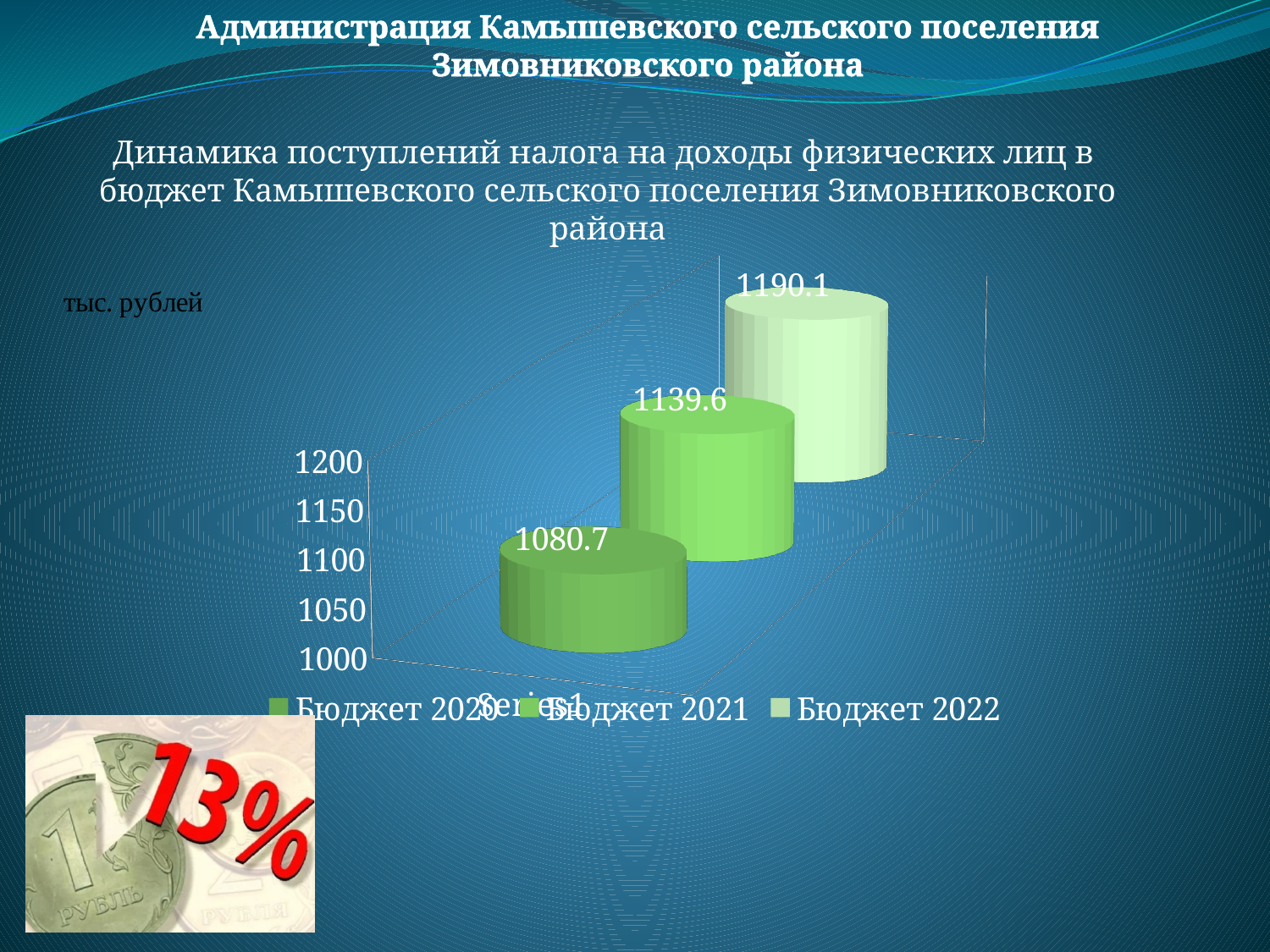
Is the value for Бюджет 2020 greater or less than 1100? less What is the difference between the values for Бюджет 2021 and Бюджет 2020? 58.9 Do the values rise or fall from Бюджет 2020 to Бюджет 2022? rise How many series does the legend list? 3 What kind of chart is shown on the slide? bar chart What is the difference between the values for Бюджет 2022 and Бюджет 2021? 50.5 Which series has the highest value? Бюджет 2022 What is the value for Бюджет 2022? 1190.1 What is the value for Бюджет 2020? 1080.7 Which is larger, the value for Бюджет 2020 or Бюджет 2021? Бюджет 2021 What is the value for Бюджет 2021? 1139.6 Which series has the lowest value? Бюджет 2020